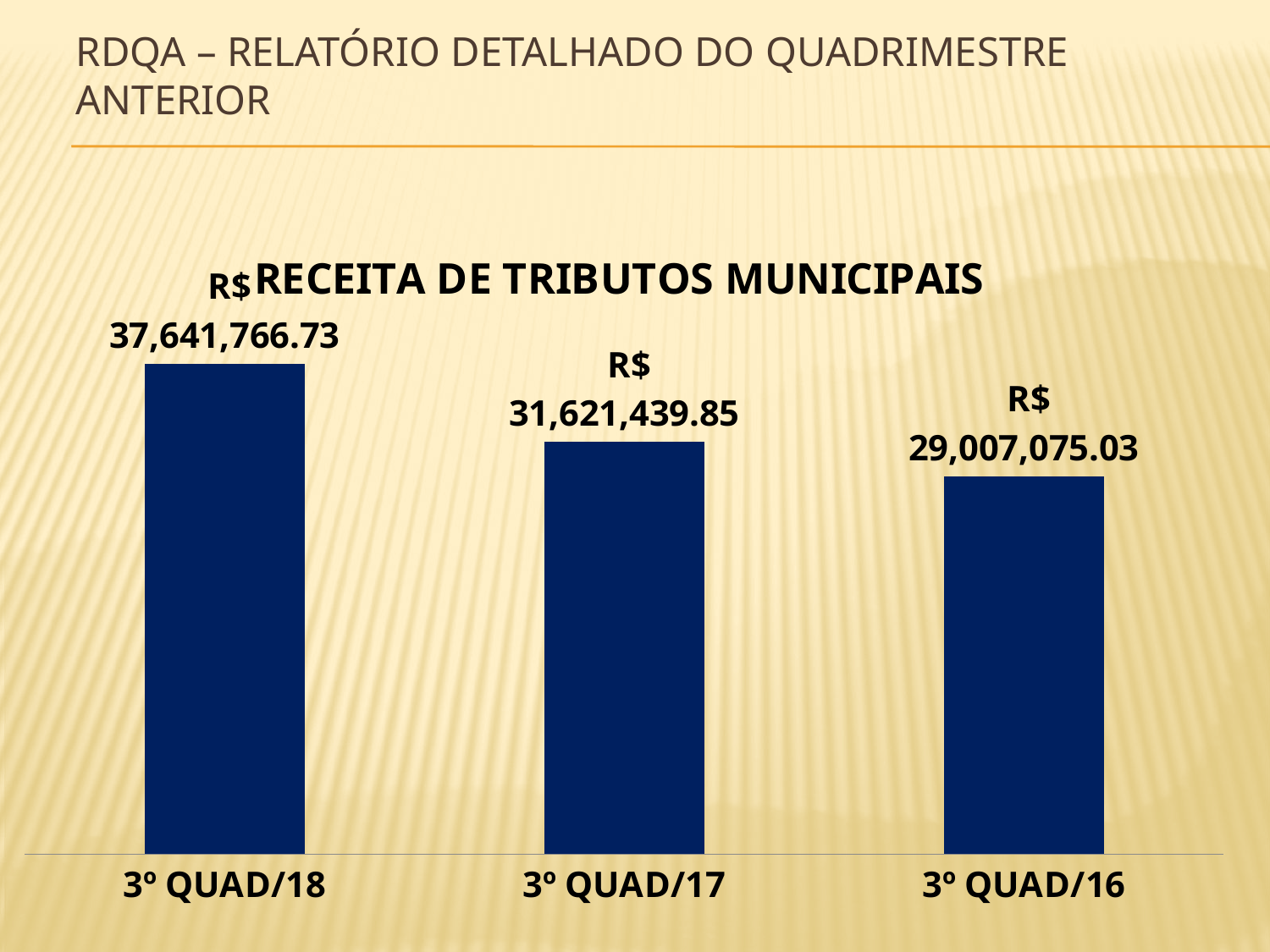
Which is larger, the value for 3º QUAD/17 or 3º QUAD/16? 3º QUAD/17 How many categories are shown in the chart? 3 What is the value for 3º QUAD/18? R$ 37,641,766.73 What is the difference between the values for 3º QUAD/17 and 3º QUAD/16? R$ 2,614,364.82 Which category has the highest value? 3º QUAD/18 What kind of chart is shown on the slide? Bar chart Which category has the lowest value? 3º QUAD/16 What is the value for 3º QUAD/17? R$ 31,621,439.85 What is the difference between the values for 3º QUAD/18 and 3º QUAD/17? R$ 6,020,326.88 What is the difference between the values for 3º QUAD/18 and 3º QUAD/16? R$ 8,634,691.70 What is the value for 3º QUAD/16? R$ 29,007,075.03 What is the title of the chart? RECEITA DE TRIBUTOS MUNICIPAIS